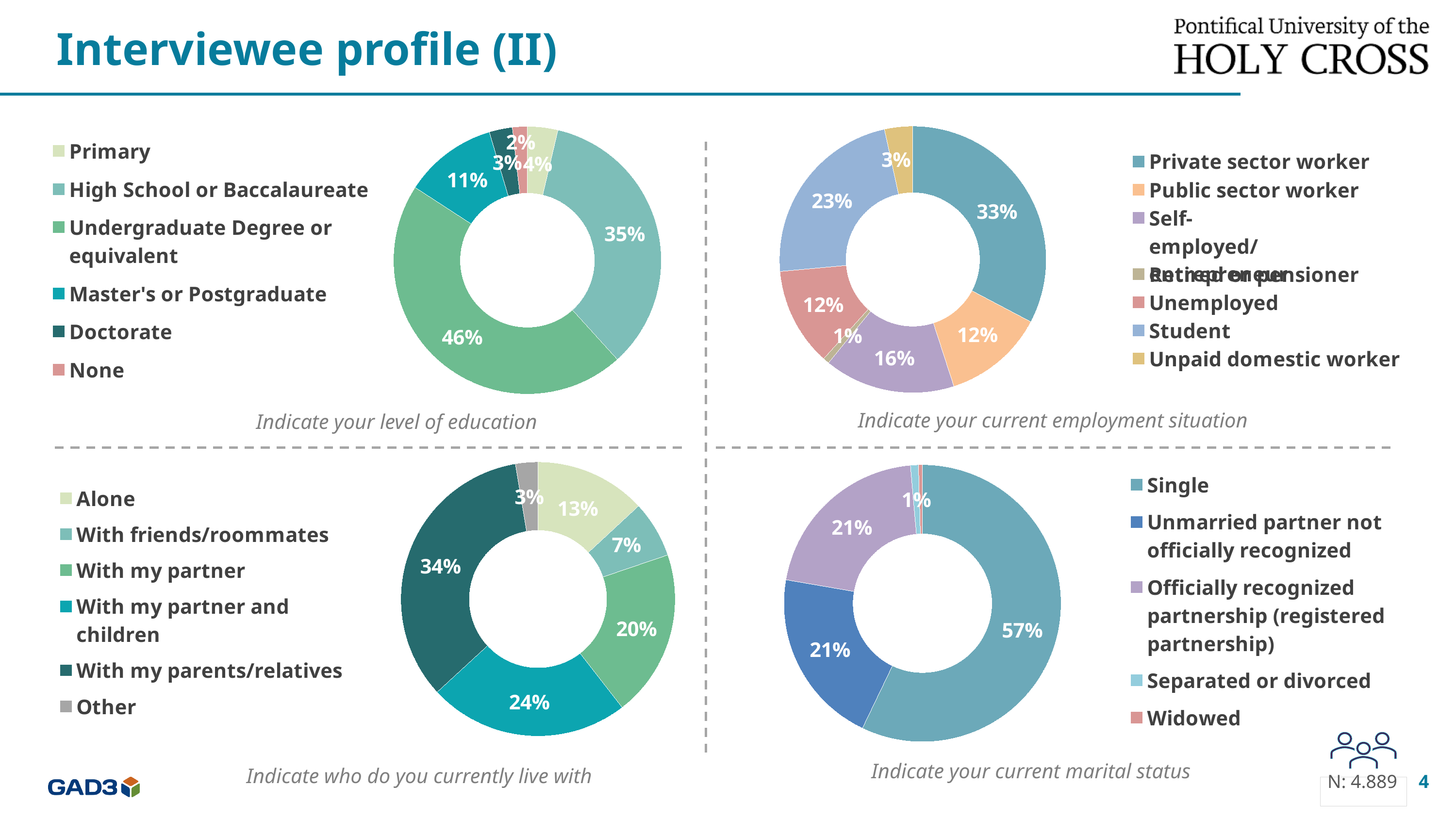
In the 'Indicate your level of education' chart, which education level has the largest share? Undergraduate Degree or equivalent In the 'Indicate your level of education' chart, what is the difference between the High School or Baccalaureate share and the Master's or Postgraduate share? 24% What type of chart is used for 'Indicate your current marital status'? Donut (pie) chart In the 'Indicate who do you currently live with' chart, which category has the smallest share? Other In the 'Indicate your level of education' chart, what percentage of interviewees have an Undergraduate Degree or equivalent? 46% In the 'Indicate your current employment situation' chart, which is larger: Public sector worker or Unpaid domestic worker? Public sector worker In the 'Indicate who do you currently live with' chart, what percentage live with their parents/relatives? 34% In the 'Indicate who do you currently live with' chart, how many categories does the legend list? 6 In the 'Indicate your current marital status' chart, what percentage of interviewees are Single? 57% In the 'Indicate your current employment situation' chart, what percentage are Private sector workers? 33% In the 'Indicate your current employment situation' chart, what percentage are Students? 23% In the 'Indicate your current marital status' chart, what is the difference between the Single share and the Separated or divorced share? 56%